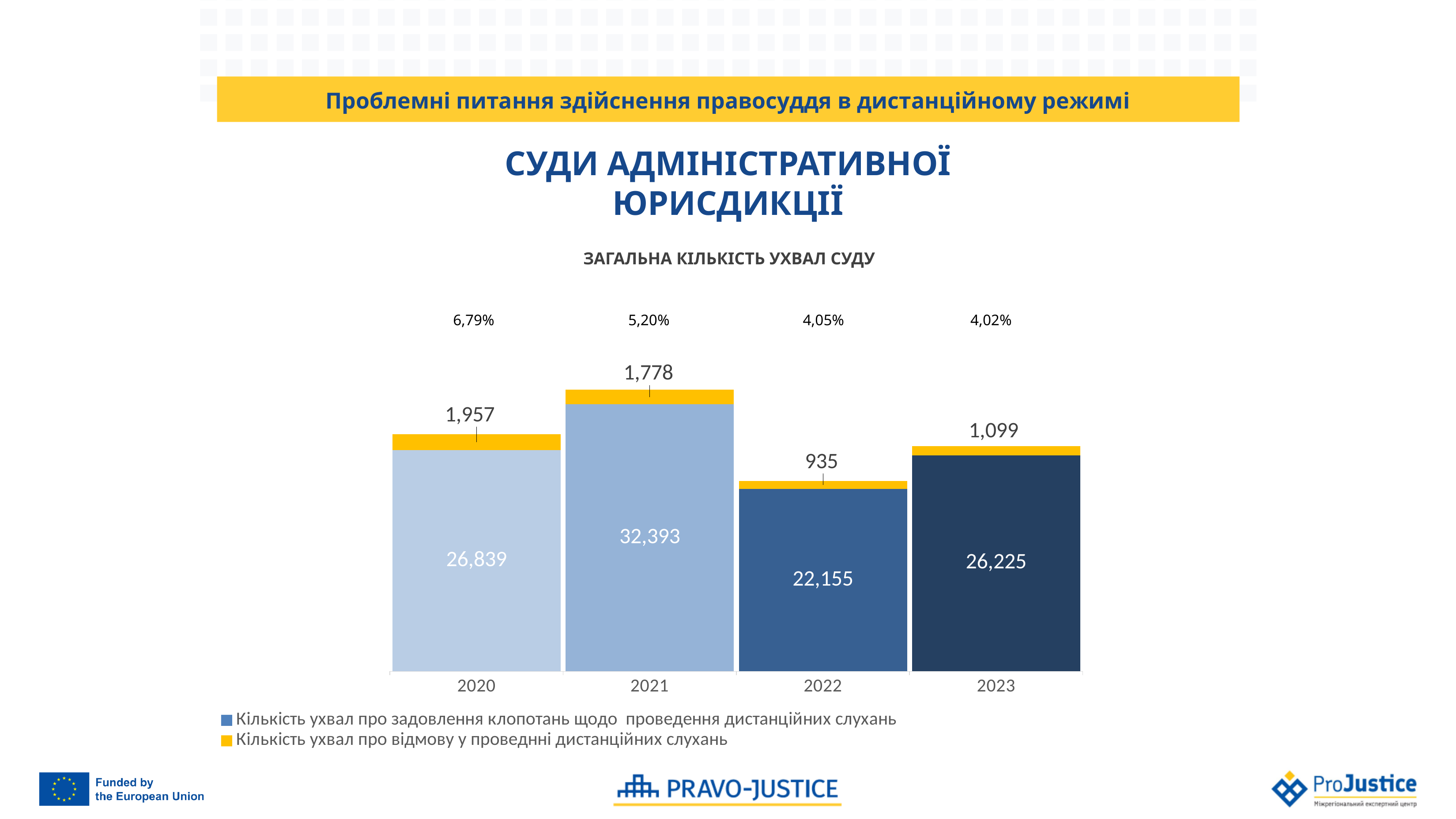
What percentage is shown above the bar for 2020? 6,79% How many years are shown on the x axis of the chart? 4 What is the total height of the stacked bar for 2022 (granted plus refused rulings)? 23,090 Which is larger: the number of rulings granting remote hearings in 2020 or in 2023? 2020 What is the number of rulings granting motions for remote hearings (blue segment) in 2021? 32,393 What is the difference between the number of rulings refusing remote hearings in 2020 and in 2022? 1,022 What is the number of rulings refusing remote hearings (yellow segment) in 2022? 935 Which year has the highest number of rulings granting motions for remote hearings? 2021 What is the difference between the number of rulings granting remote hearings in 2021 and in 2020? 5,554 What type of chart is shown on the slide? Stacked bar chart How many series does the chart legend list? 2 Which year has the lowest number of rulings refusing remote hearings? 2022